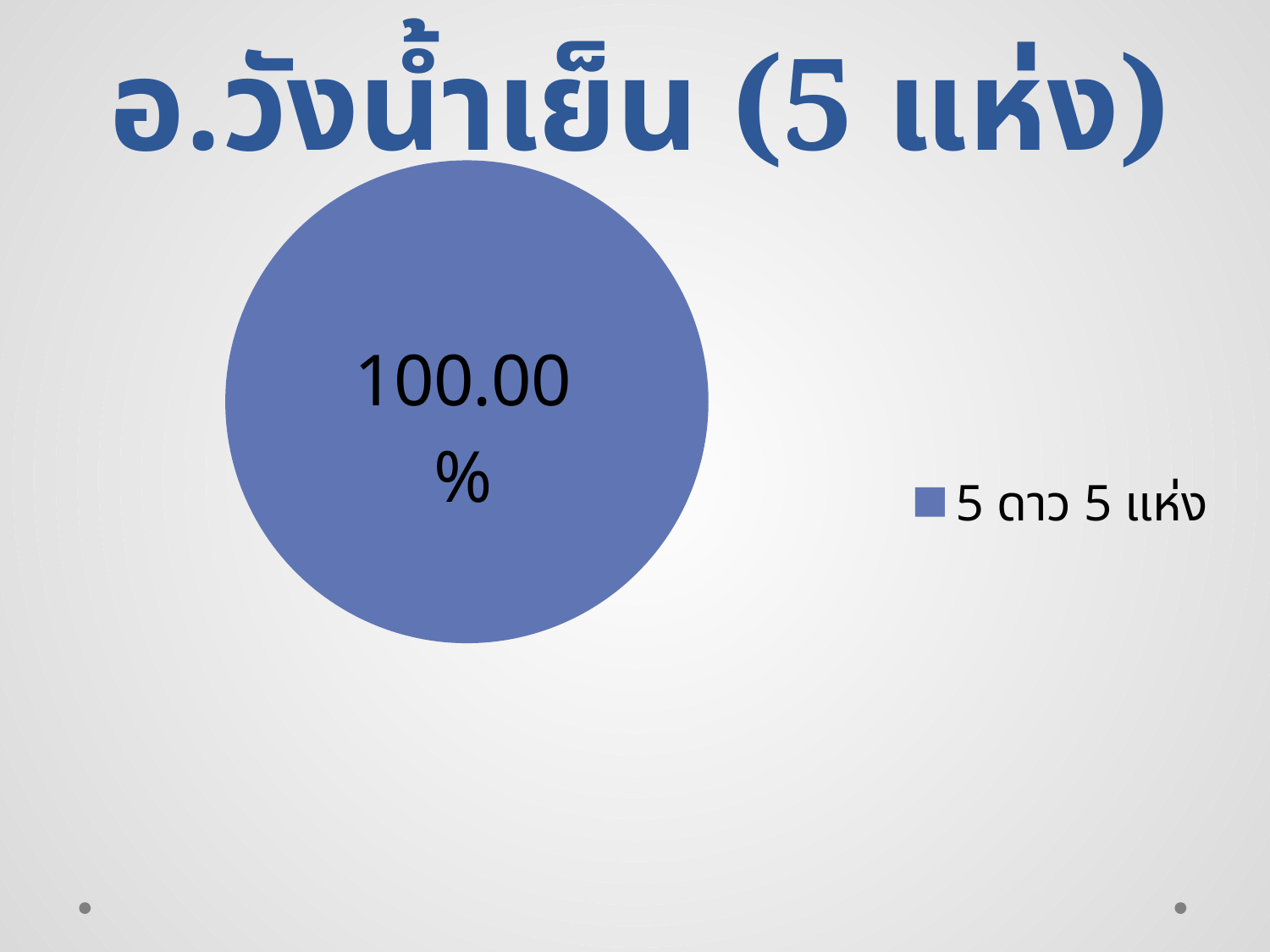
What kind of chart is shown on the slide? pie chart How many entries does the legend list? 1 How many slices does the pie chart have? 1 What share of the pie does the slice labelled "5 ดาว 5 แห่ง" represent? 100.00% What is the title of the chart? อ.วังน้ำเย็น (5 แห่ง) What is the legend entry for the single slice? 5 ดาว 5 แห่ง What value is printed on the pie slice? 100.00%